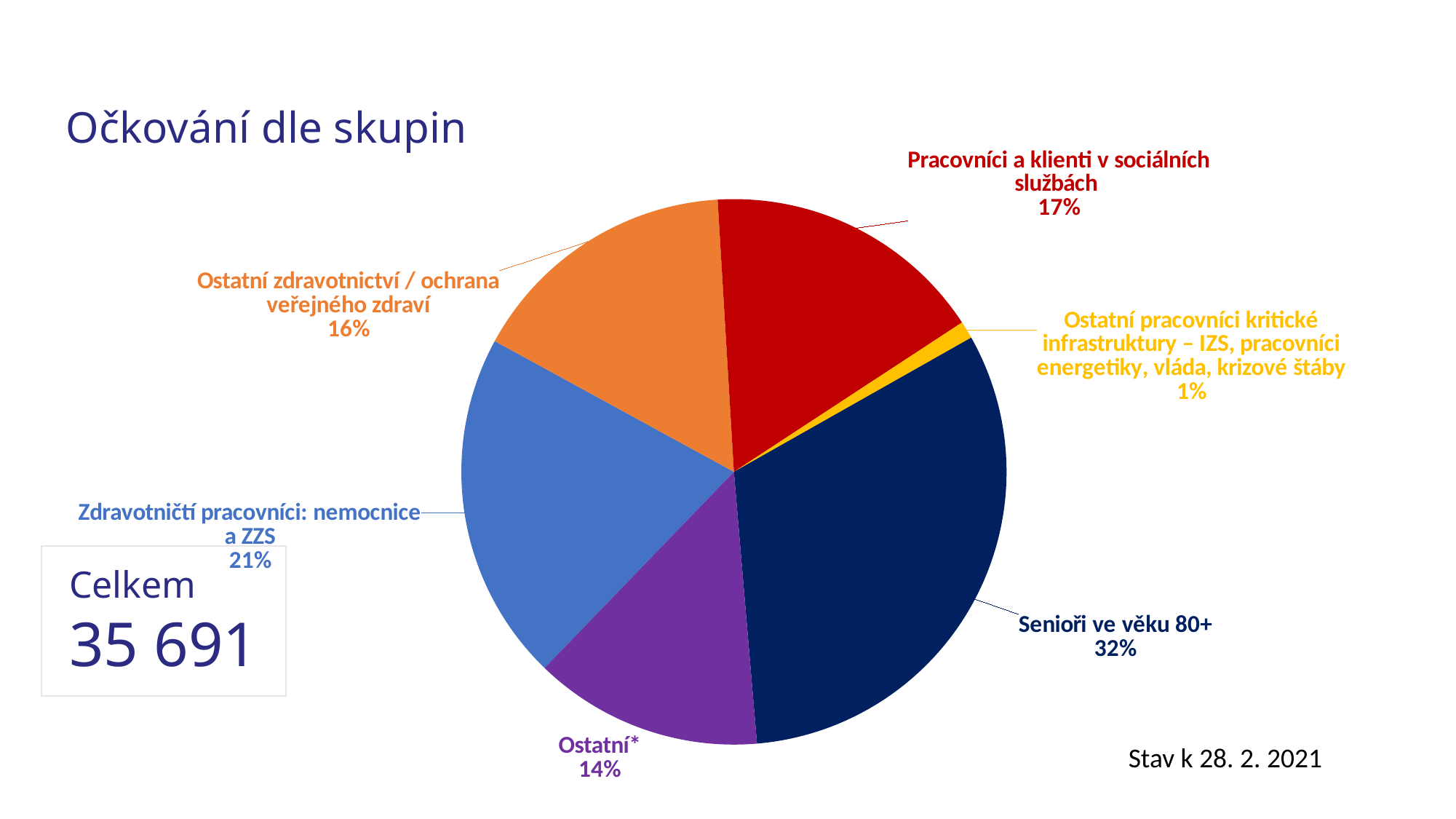
What is the difference in percentage points between "Senioři ve věku 80+" and "Ostatní*"? 18 How many slices does the pie chart have? 6 What is the title of the chart on the slide? Očkování dle skupin Which is larger: the share for "Zdravotničtí pracovníci: nemocnice a ZZS" or for "Pracovníci a klienti v sociálních službách"? Zdravotničtí pracovníci: nemocnice a ZZS What share of the pie does "Ostatní*" have? 14% What share of the pie does "Pracovníci a klienti v sociálních službách" have? 17% Which group has the largest slice of the pie? Senioři ve věku 80+ What share of the pie does "Senioři ve věku 80+" have? 32% Which group has the smallest slice of the pie? Ostatní pracovníci kritické infrastruktury – IZS, pracovníci energetiky, vláda, krizové štáby What kind of chart is shown on the slide? Pie chart